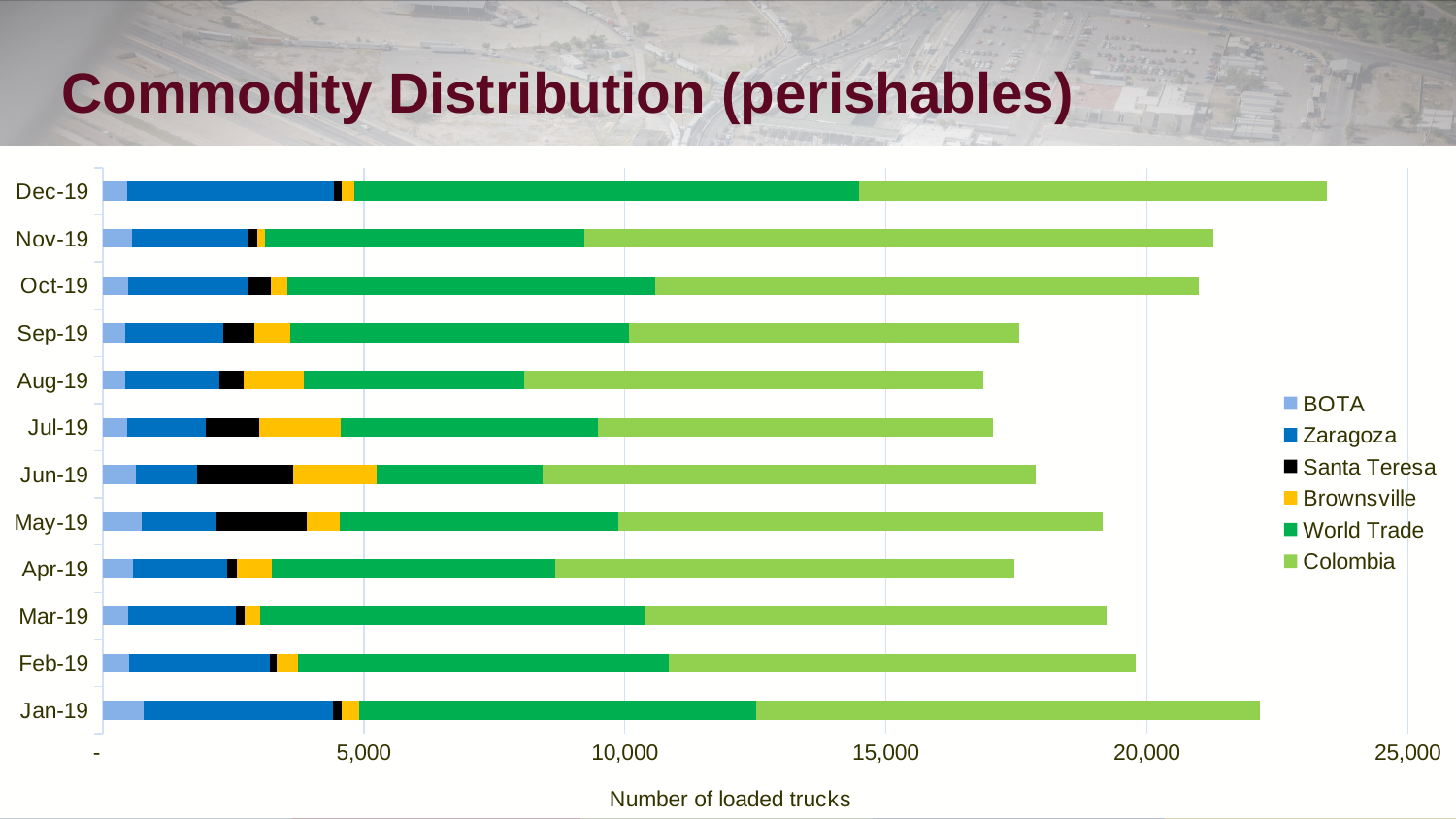
How many months (categories) are plotted on the chart? 12 Is the total number of loaded trucks for Aug-19 greater or less than 20,000? less Is the total number of loaded trucks for Dec-19 greater or less than 20,000? greater Which has a larger total number of loaded trucks, Dec-19 or Aug-19? Dec-19 How many series does the legend list? 6 Which series is shown in the light green colour at the right end of each bar? Colombia Is the total number of loaded trucks for Jan-19 greater or less than 20,000? greater What kind of chart is shown on the slide? Stacked bar chart Which month has the longest total bar (highest number of loaded trucks)? Dec-19 What is the title of the chart's horizontal axis? Number of loaded trucks Which has a larger total number of loaded trucks, Nov-19 or Sep-19? Nov-19